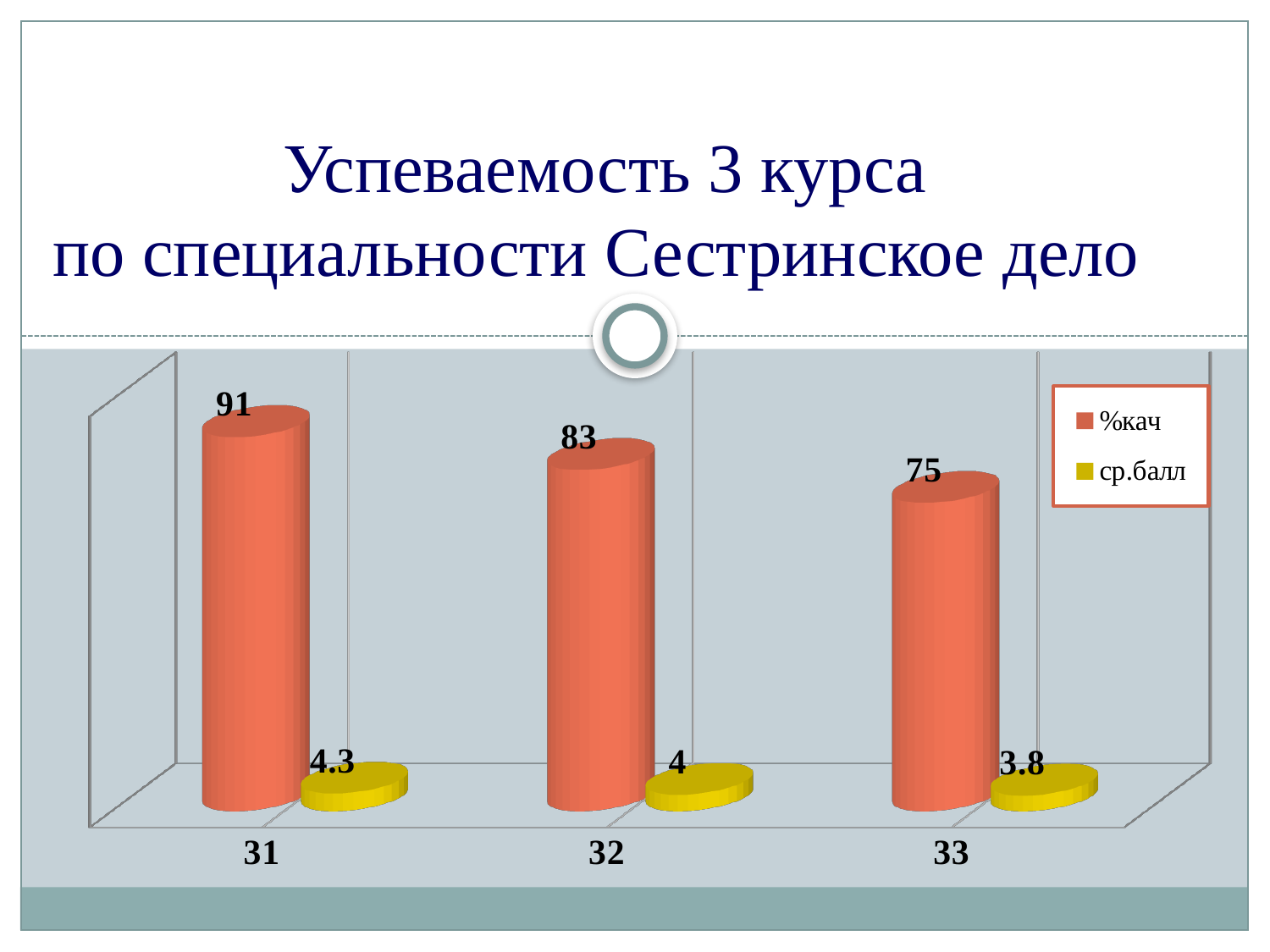
How many series does the legend list? 2 What is the %кач value for group 32? 83 Which group has a larger ср.балл value, 31 or 32? 31 Which group has the lowest ср.балл value? 33 What is the ср.балл value for group 32? 4 What is the %кач value for group 31? 91 What is the ср.балл value for group 33? 3.8 Which group has the highest %кач value? 31 Do the %кач values rise or fall from group 31 to group 33? Fall What is the difference between the %кач values for groups 31 and 33? 16 How many groups are shown on the x axis? 3 What kind of chart is shown on the slide? Bar chart